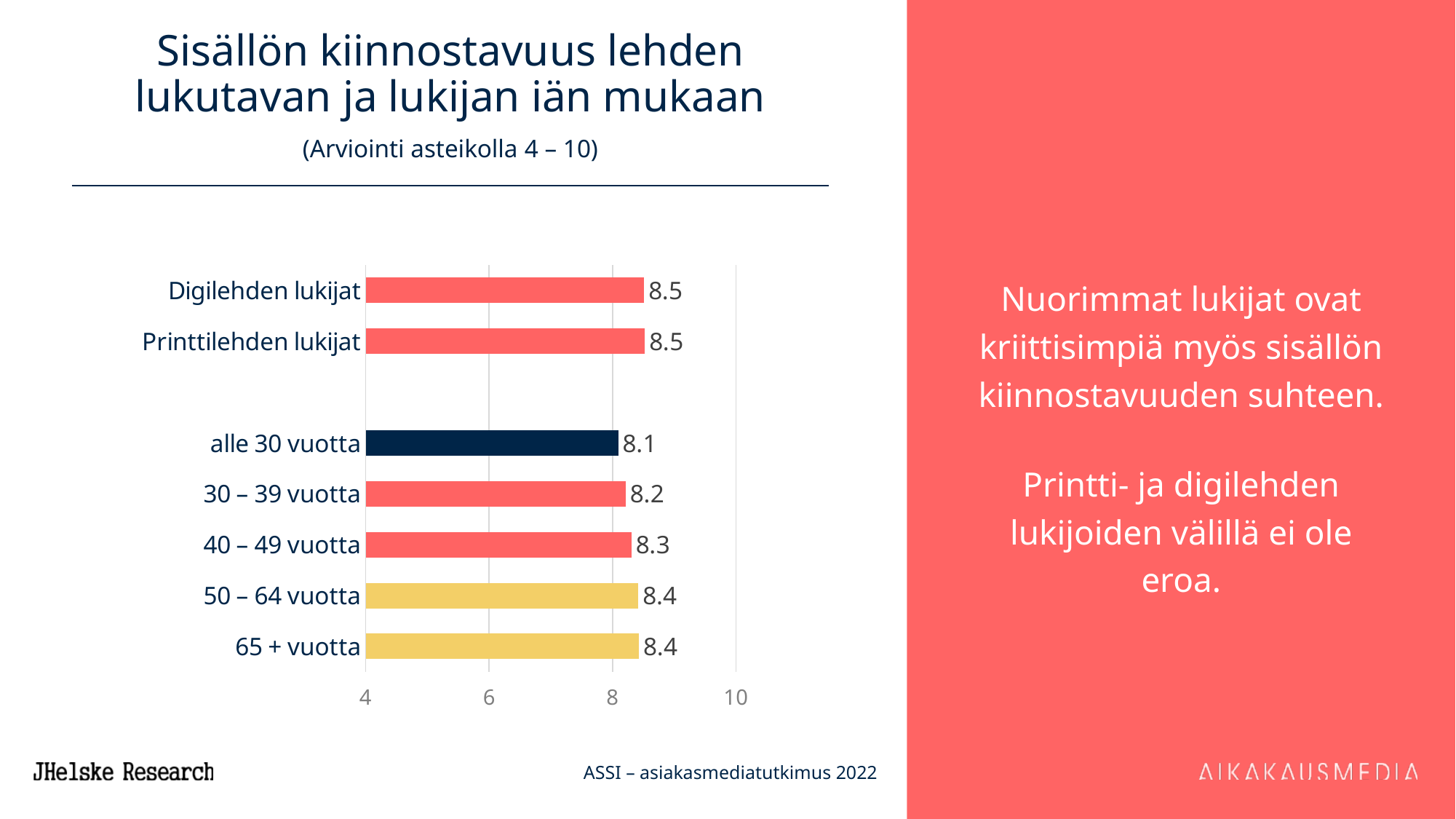
What is the value for alle 30 vuotta? 8.1 Which age group has the lowest value? alle 30 vuotta Which is larger, the value for 30 – 39 vuotta or the value for 40 – 49 vuotta? 40 – 49 vuotta What rating scale is stated under the chart title? 4 – 10 Is the value for Printtilehden lukijat greater or less than 8? greater What is the value for 65 + vuotta? 8.4 What kind of chart is shown on the slide? bar chart Do the values rise or fall going from alle 30 vuotta to 50 – 64 vuotta? rise What is the value for Digilehden lukijat? 8.5 How many categories are shown in the chart? 7 What is the difference between the values for 50 – 64 vuotta and alle 30 vuotta? 0.3 What is the value for 40 – 49 vuotta? 8.3